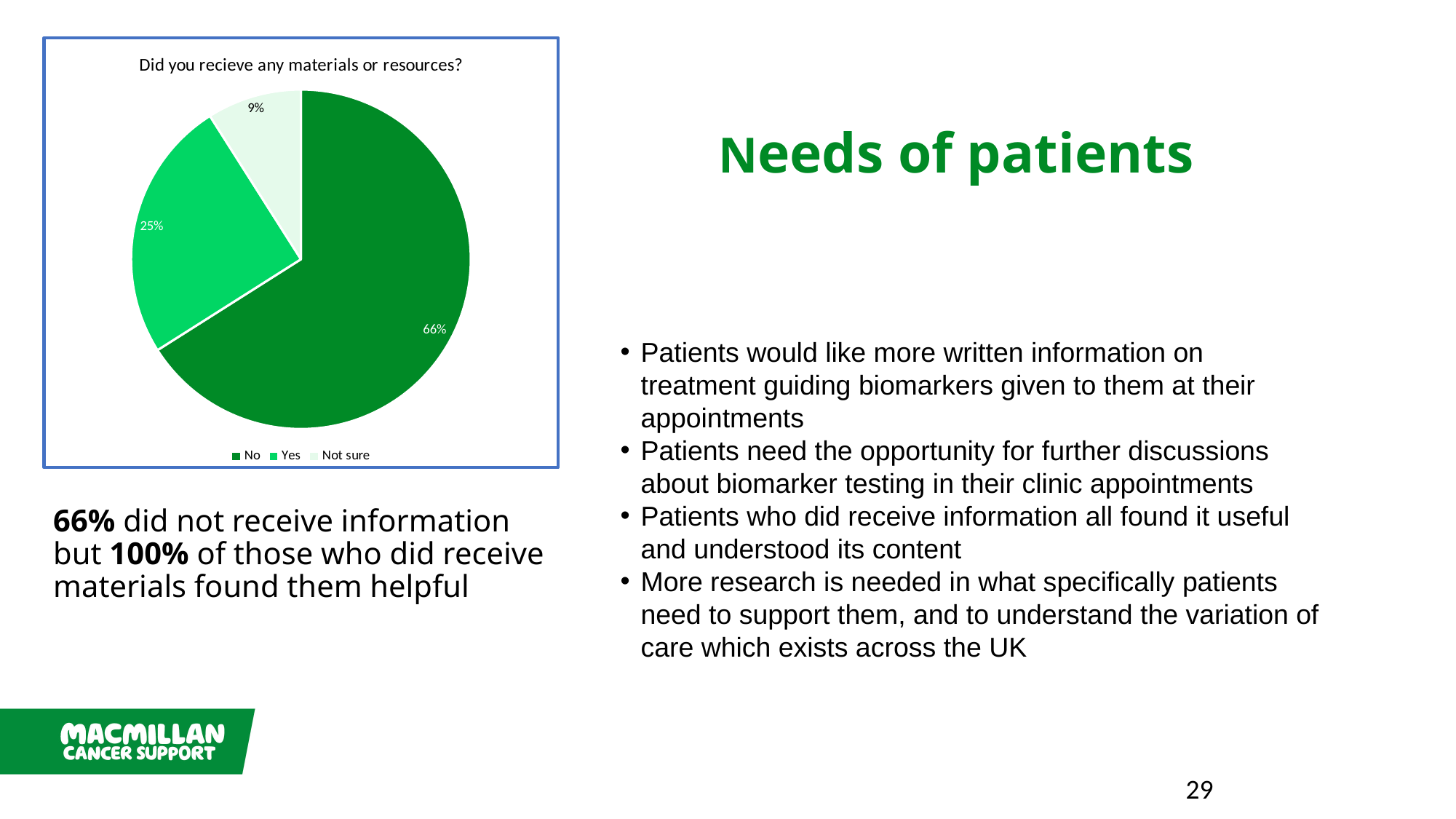
What kind of chart is shown on the slide? pie chart How many entries does the legend list? 3 Which is larger, the "Yes" slice or the "Not sure" slice? Yes How many slices does the pie chart have? 3 Which response has the largest share of the pie? No What percentage of respondents answered "Not sure"? 9% What percentage of respondents answered "Yes"? 25% Which legend entry is shown in the lightest green colour? Not sure What percentage of respondents answered "No"? 66% What is the difference in percentage points between the "No" and "Yes" slices? 41 Which response has the smallest share of the pie? Not sure What is the title of the chart? Did you recieve any materials or resources?